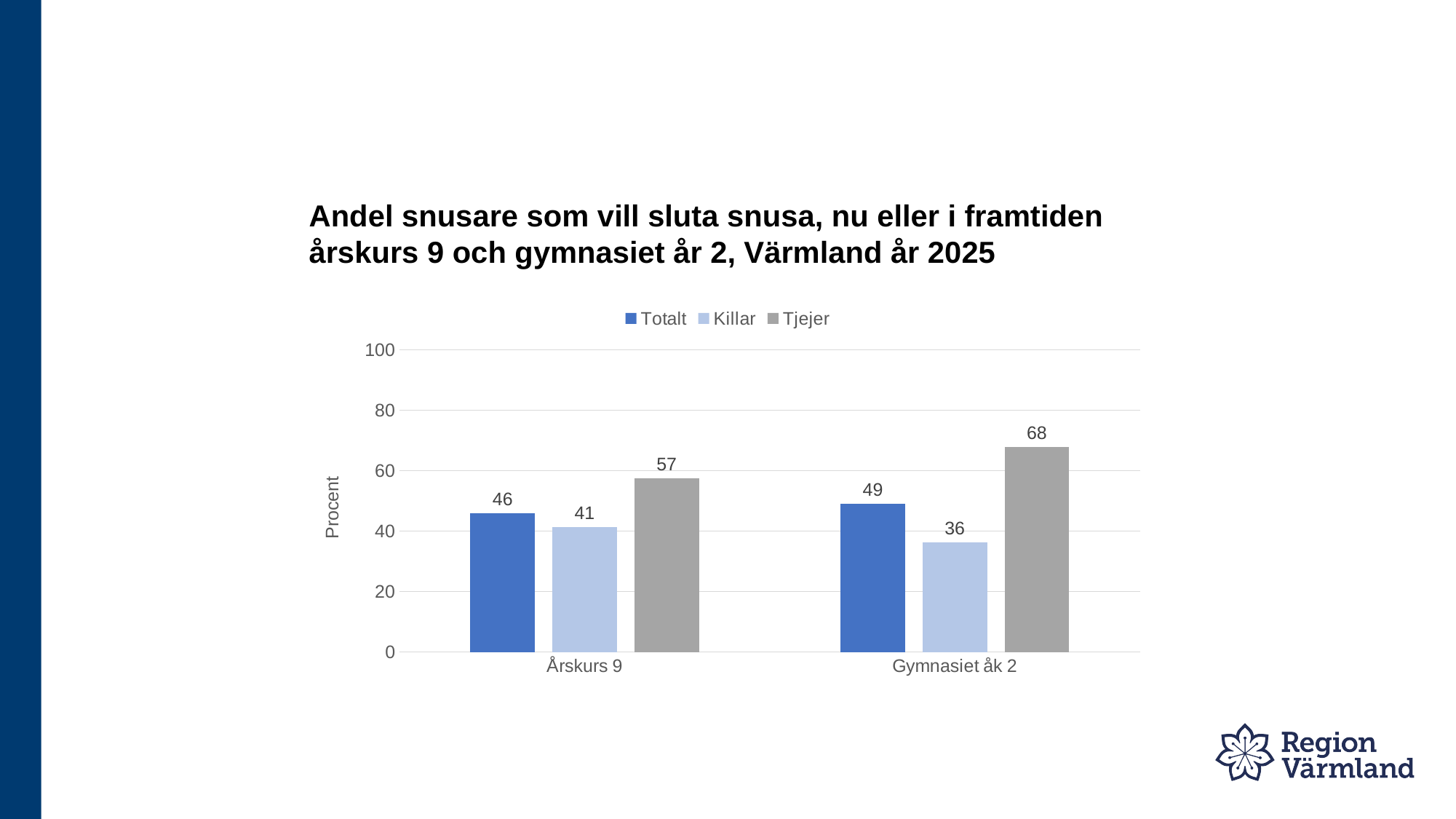
How many categories are shown on the x axis? 2 What kind of chart is shown on the slide? Bar chart What is the value for Tjejer in Gymnasiet åk 2? 68 Which series has the highest value in Årskurs 9? Tjejer What is the difference between Tjejer and Killar in Gymnasiet åk 2? 32 What is the label of the y axis? Procent What is the value for Killar in Årskurs 9? 41 How many series does the legend list? 3 Which is larger: Killar in Årskurs 9 or Killar in Gymnasiet åk 2? Killar in Årskurs 9 What is the difference between the Totalt values for Gymnasiet åk 2 and Årskurs 9? 3 What is the value for Totalt in Gymnasiet åk 2? 49 Which series has the lowest value in Gymnasiet åk 2? Killar